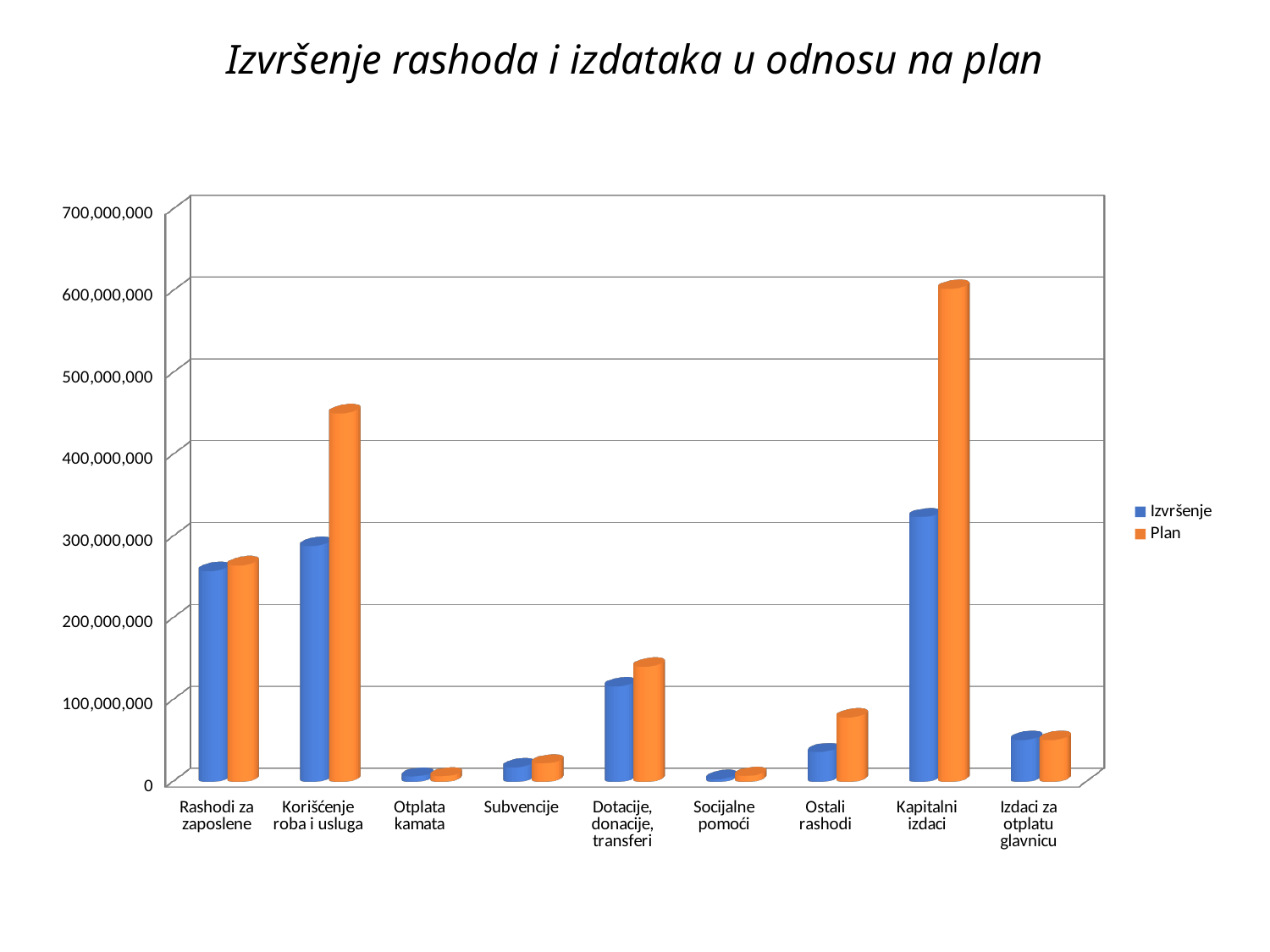
Is the Plan value for Ostali rashodi greater or less than 100,000,000? less Is the Plan value for Korišćenje roba i usluga greater or less than 400,000,000? greater For Korišćenje roba i usluga, which is larger: Izvršenje or Plan? Plan What kind of chart is shown on the slide? bar chart What is the title of the chart? Izvršenje rashoda i izdataka u odnosu na plan For Kapitalni izdaci, which is larger: Izvršenje or Plan? Plan Is the Plan value for Dotacije, donacije, transferi greater or less than 100,000,000? greater How many series does the legend list? 2 How many categories are shown on the x axis? 9 Which category has the highest Plan value? Kapitalni izdaci Which category has the highest Izvršenje value? Kapitalni izdaci